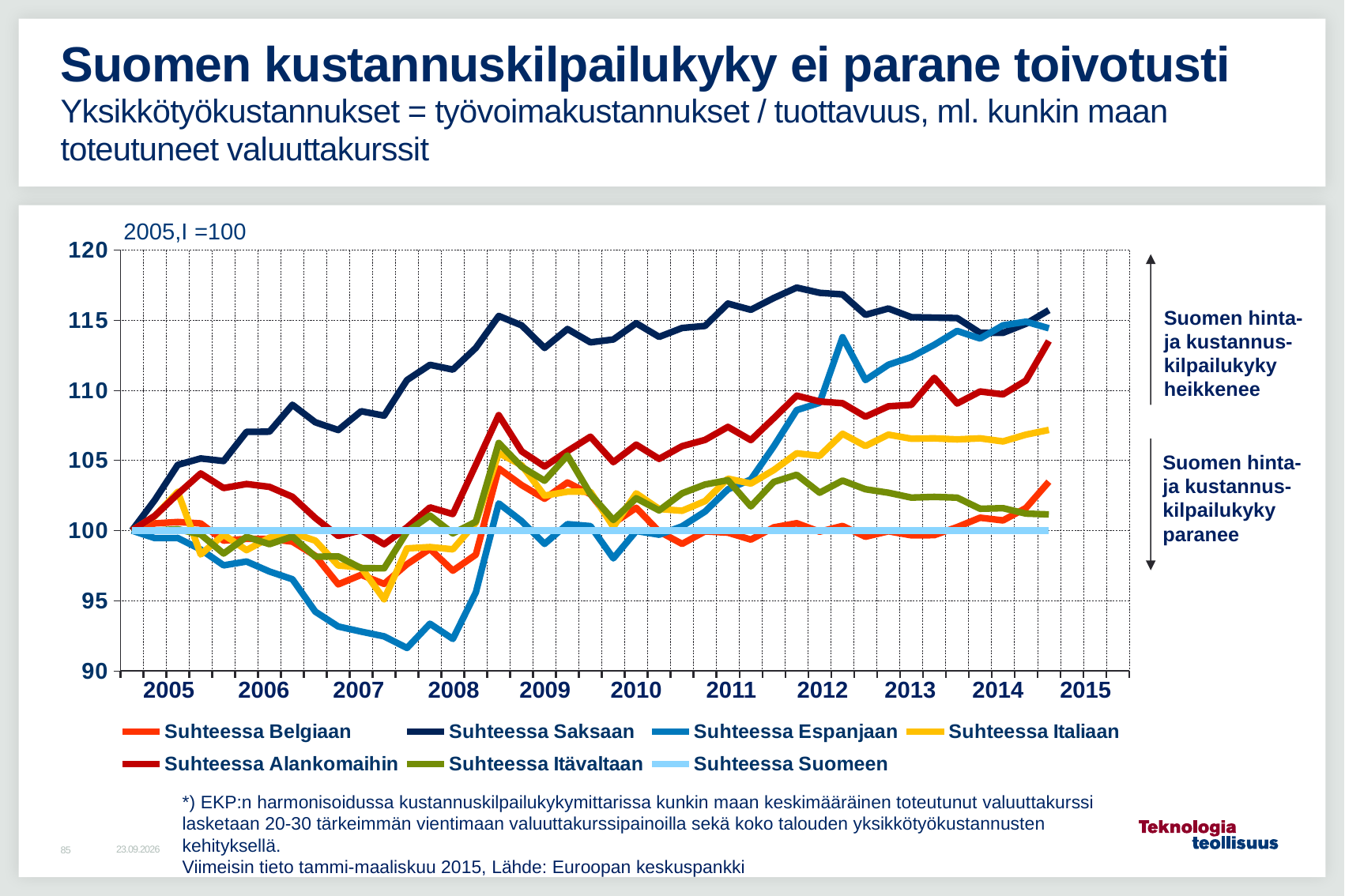
Which is larger in 2010, Suhteessa Saksaan or Suhteessa Belgiaan? Suhteessa Saksaan What constant value does the Suhteessa Suomeen series stay at? 100 Is the value for Suhteessa Saksaan in 2011 greater or less than 110? greater Which series is the highest in 2010? Suhteessa Saksaan How many series does the legend list? 7 Is the value for Suhteessa Belgiaan in 2011 greater or less than 105? less What kind of chart is shown on the slide? line chart What index base is noted above the chart? 2005,I =100 Does the Suhteessa Saksaan series rise or fall from 2005 to 2008? rise Which series is the lowest in 2007? Suhteessa Espanjaan Is the value for Suhteessa Alankomaihin in 2014 greater or less than 105? greater